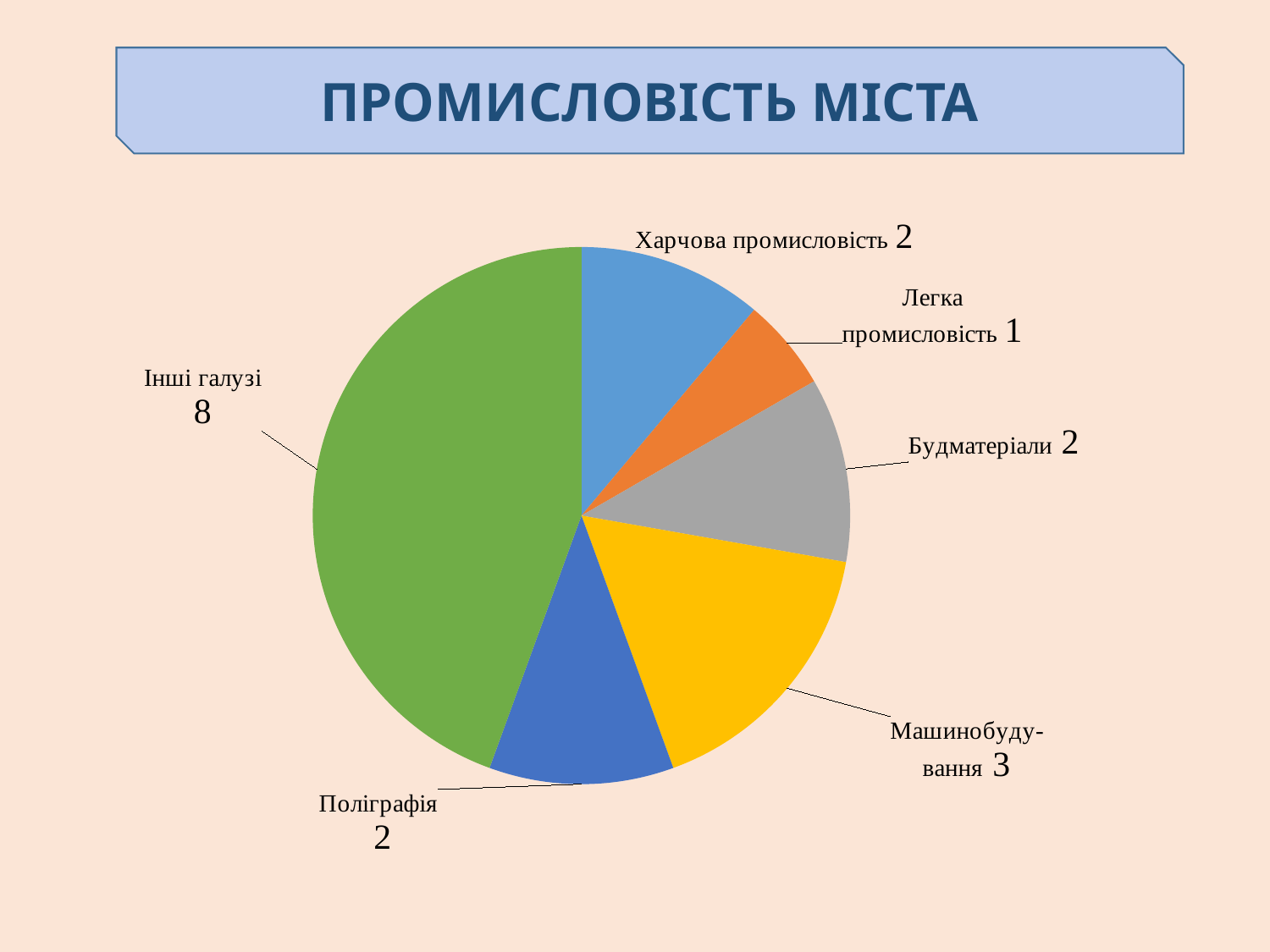
What is the value for Машинобудування? 3 What is the difference between the values for Інші галузі and Машинобудування? 5 What is the title of the slide? ПРОМИСЛОВІСТЬ МІСТА What kind of chart is shown on the slide? pie chart Which category has the smallest slice of the pie? Легка промисловість Which is larger, the value for Машинобудування or the value for Будматеріали? Машинобудування How many categories are shown in the pie chart? 6 What is the value for Легка промисловість? 1 What is the value for Інші галузі? 8 What is the value for Поліграфія? 2 Which category has the largest slice of the pie? Інші галузі What is the total of all the values shown in the pie chart? 18